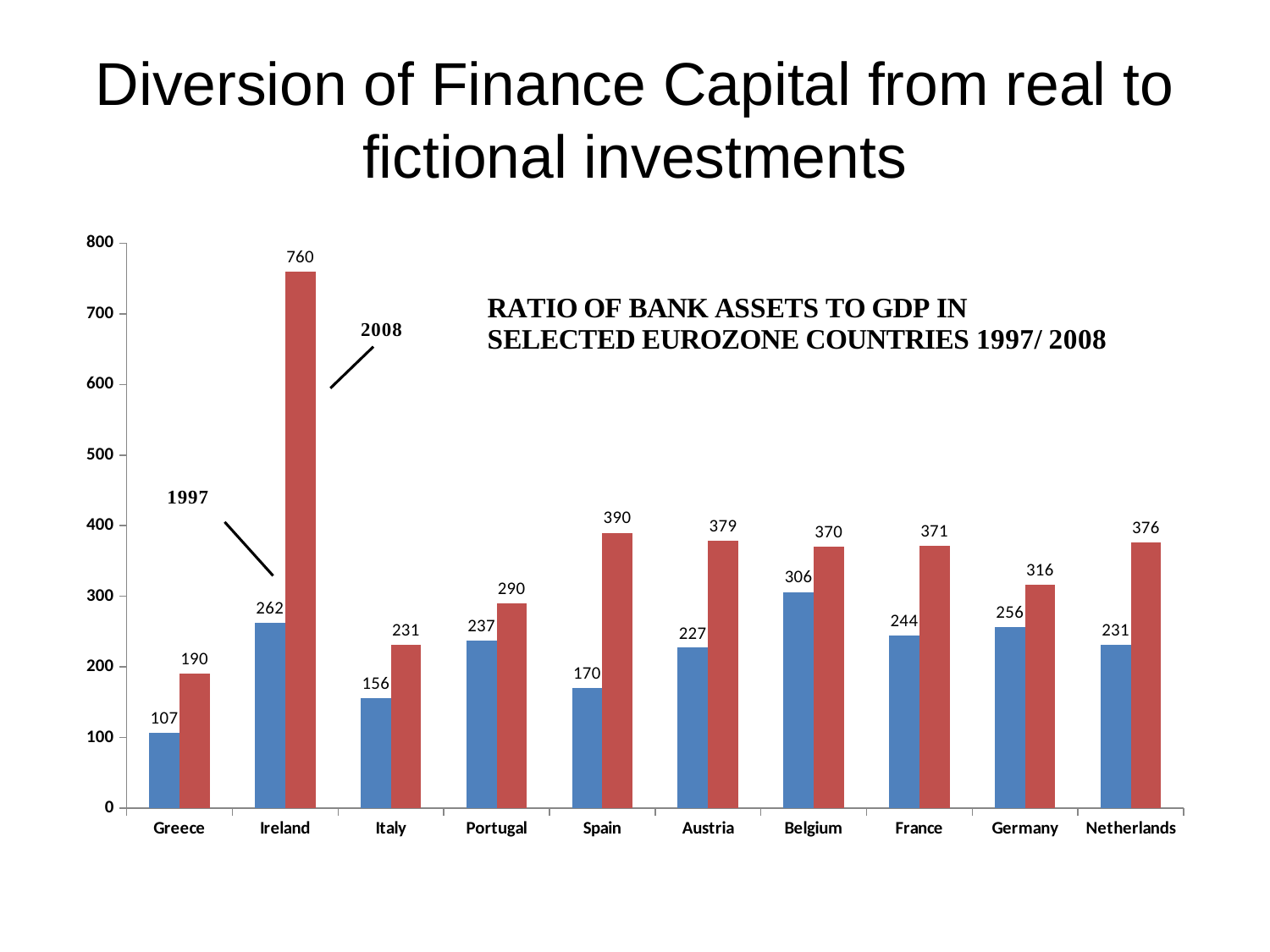
What is the difference between the 2008 and 1997 values for Spain? 220 What is the difference between the 2008 and 1997 values for Ireland? 498 What kind of chart is shown on the slide? bar chart Which country has the lowest 1997 value? Greece What is the 2008 value for Spain? 390 What is the 2008 value for Ireland? 760 Which is larger, the 1997 value for Belgium or the 1997 value for Germany? Belgium What is the 1997 value for Greece? 107 Which year do the red bars represent? 2008 Is the 2008 value for Portugal greater or less than 300? less Which country has the highest 2008 value? Ireland How many countries are shown on the x axis? 10